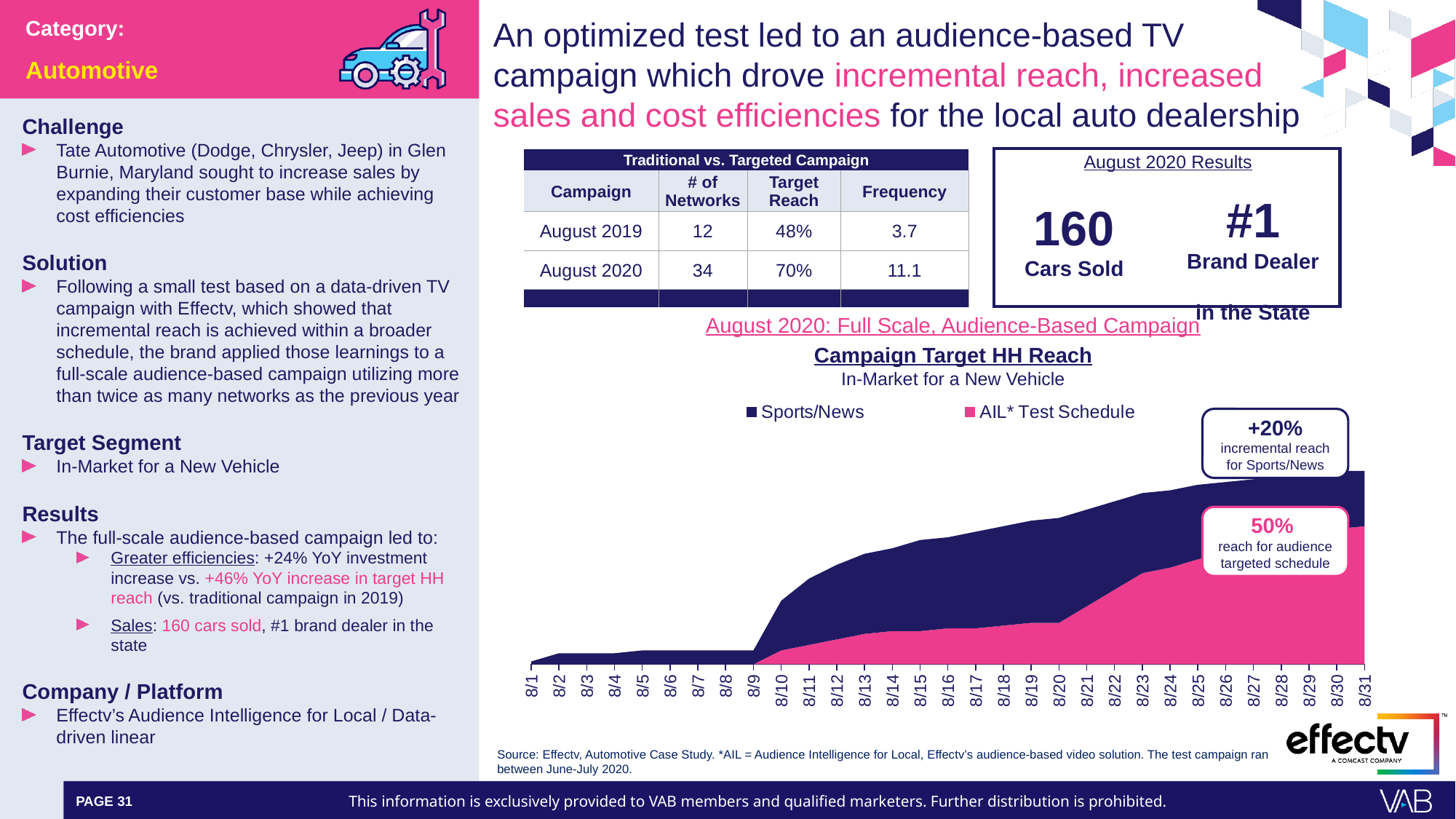
What subtitle appears under the title of the Campaign Target HH Reach chart? In-Market for a New Vehicle How many series does the legend of the Campaign Target HH Reach chart list? 2 How many dates are shown along the x axis of the Campaign Target HH Reach chart? 31 At 8/31 in the Campaign Target HH Reach chart, which series contributes more reach: Sports/News or AIL* Test Schedule? AIL* Test Schedule What is the first date shown on the x axis of the Campaign Target HH Reach chart? 8/1 According to the callout on the Campaign Target HH Reach chart, what reach did the audience targeted schedule achieve? 50% According to the callout on the Campaign Target HH Reach chart, how much incremental reach did Sports/News add? +20% What is the last date shown on the x axis of the Campaign Target HH Reach chart? 8/31 What kind of chart is the Campaign Target HH Reach chart? Stacked area chart Does the total reach in the Campaign Target HH Reach chart rise or fall from 8/1 to 8/31? Rise What are the two series named in the legend of the Campaign Target HH Reach chart? Sports/News and AIL* Test Schedule